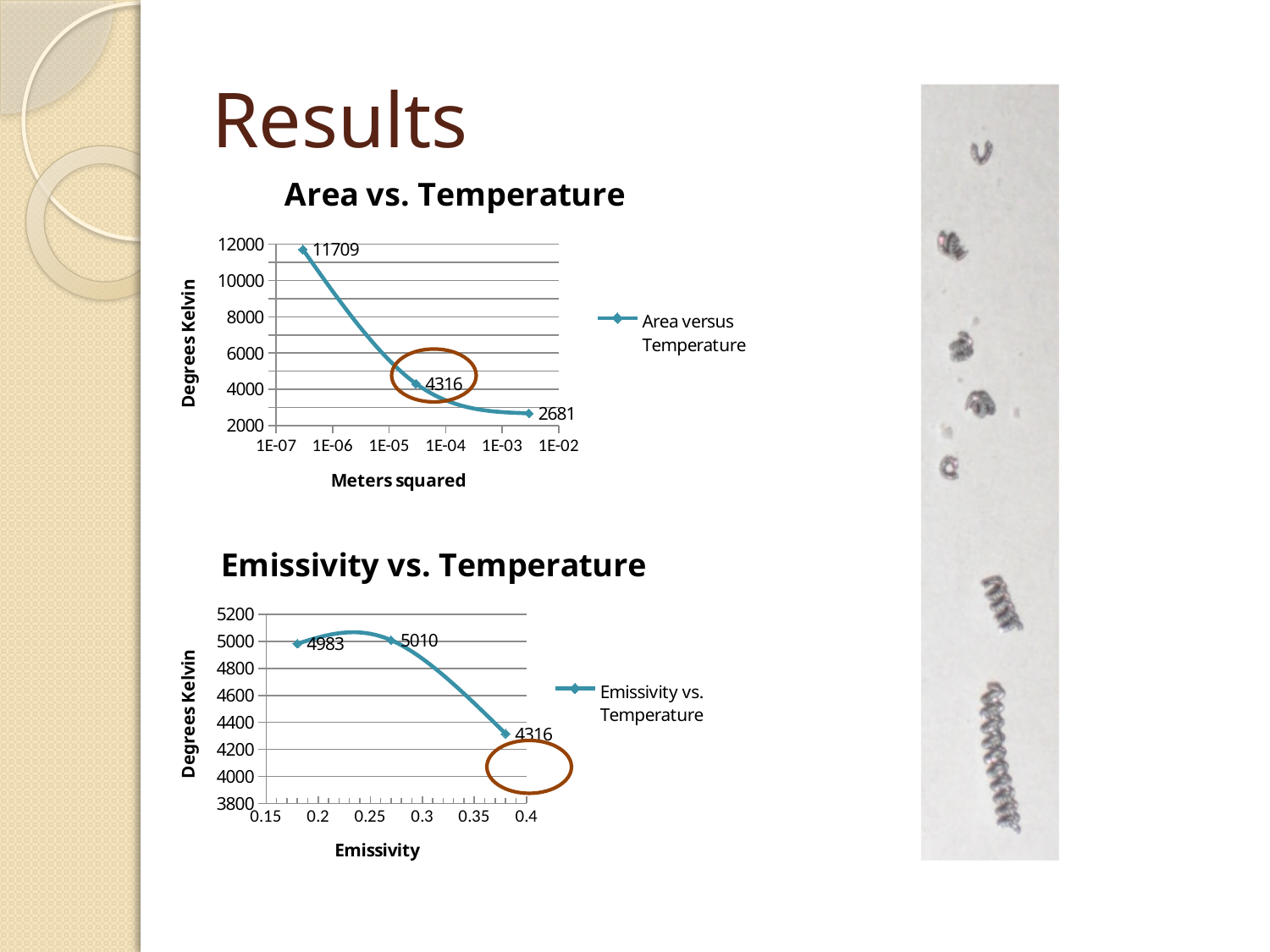
In the Emissivity vs. Temperature chart, what is the lowest temperature value labeled? 4316 In the Area vs. Temperature chart, what is the lowest temperature value labeled? 2681 In the Area vs. Temperature chart, do the temperature values rise or fall as area increases along the x axis? fall In the Emissivity vs. Temperature chart, what is the highest temperature value labeled? 5010 In the Emissivity vs. Temperature chart, what is the label of the x axis? Emissivity In the Area vs. Temperature chart, what is the value of the circled data point? 4316 In the Emissivity vs. Temperature chart, what is the difference between the values 5010 and 4983? 27 In the Area vs. Temperature chart, how many data points are plotted? 3 In the Emissivity vs. Temperature chart, how many series does the legend list? 1 In the Area vs. Temperature chart, what is the label of the y axis? Degrees Kelvin In the Area vs. Temperature chart, what is the highest temperature value labeled? 11709 In the Area vs. Temperature chart, what is the difference between the highest and lowest labeled values? 9028